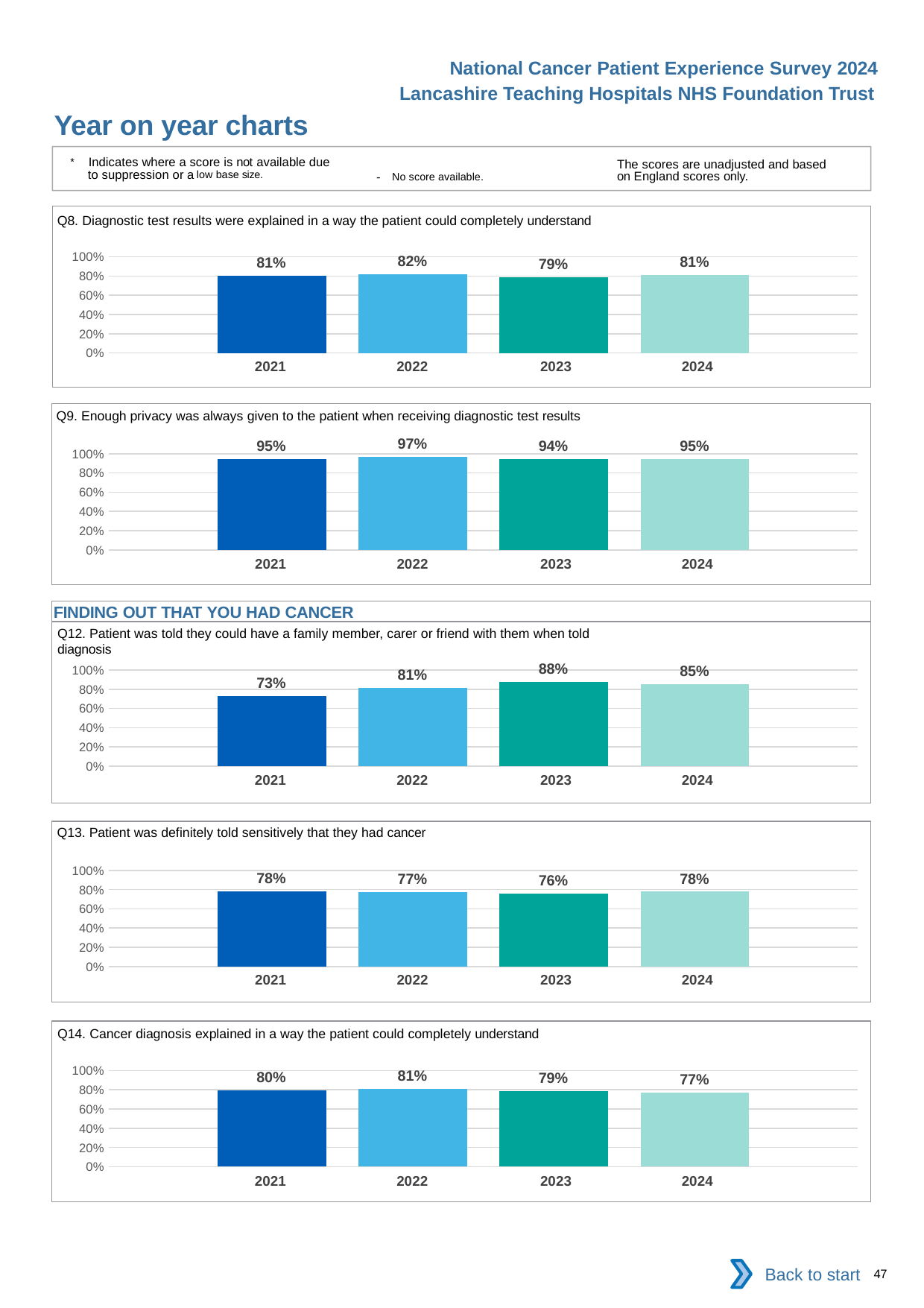
In the Q13 chart (Patient was definitely told sensitively that they had cancer), which is larger, the value for 2021 or the value for 2023? 2021 In the Q12 chart, which year has the highest value? 2023 In the Q14 chart, do the values rise or fall from 2022 to 2024? fall How many years are shown on the x axis of the Q13 chart? 4 In the Q9 chart, what is the difference between the 2022 value and the 2023 value? 3 percentage points In the Q8 chart, which year has the lowest value? 2023 What kind of chart is the Q8 chart? bar chart In the Q12 chart (Patient was told they could have a family member, carer or friend with them when told diagnosis), what is the value for 2021? 73% In the Q12 chart, what is the difference between the 2023 value and the 2021 value? 15 percentage points In the Q8 chart (Diagnostic test results were explained in a way the patient could completely understand), what is the value for 2022? 82% In the Q14 chart (Cancer diagnosis explained in a way the patient could completely understand), what is the value for 2024? 77% In the Q9 chart (Enough privacy was always given to the patient when receiving diagnostic test results), which year has the highest value? 2022